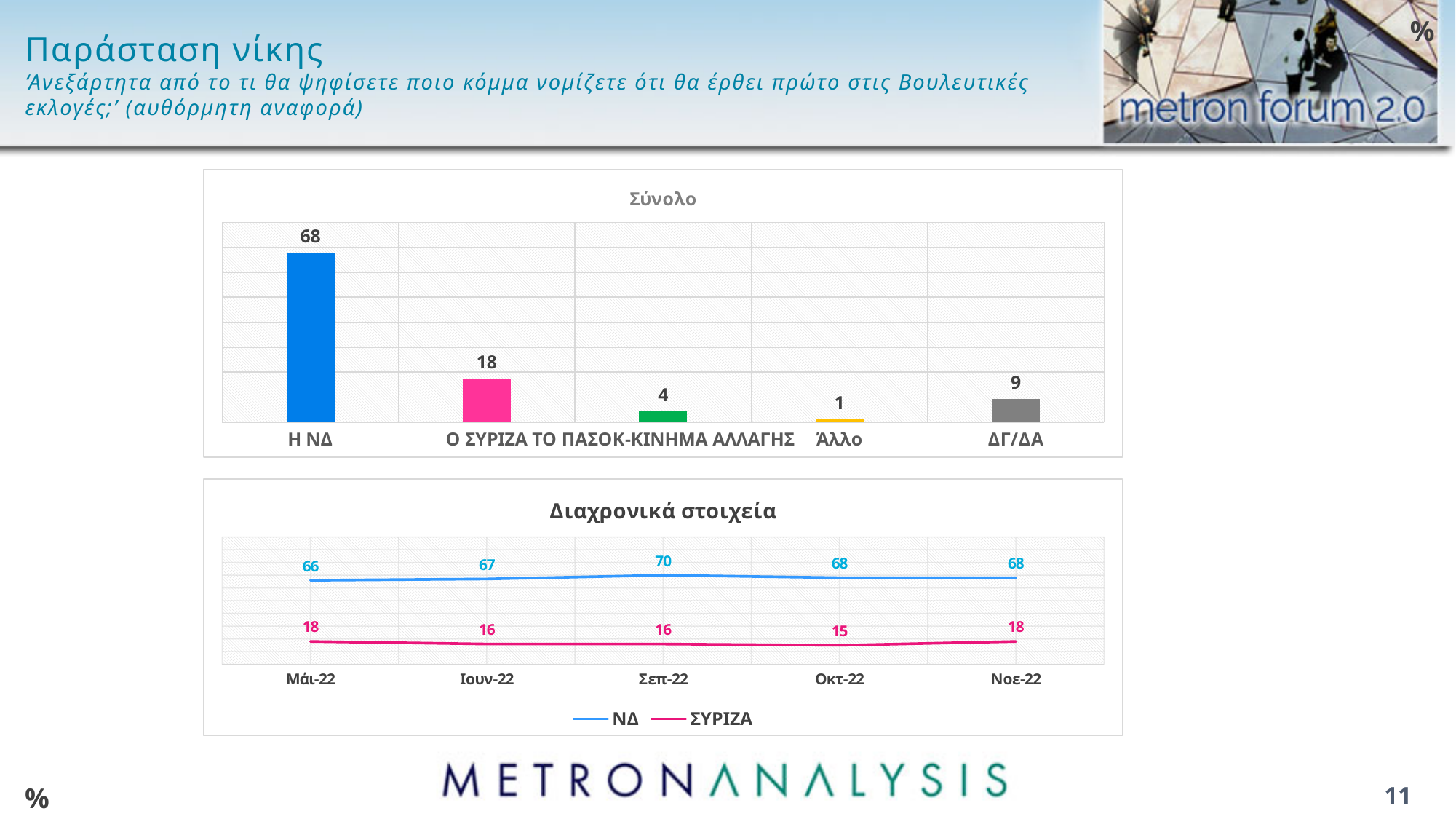
In the 'Σύνολο' chart, what is the value for ΔΓ/ΔΑ? 9 In the 'Σύνολο' chart, what is the difference between Η ΝΔ and Ο ΣΥΡΙΖΑ? 50 What kind of chart is the 'Σύνολο' chart? bar chart In the 'Διαχρονικά στοιχεία' chart, what is the difference between ΝΔ and ΣΥΡΙΖΑ in Νοε-22? 50 In the 'Διαχρονικά στοιχεία' chart, what is the value for ΝΔ in Σεπ-22? 70 In the 'Σύνολο' chart, which category has the lowest value? Άλλο In the 'Διαχρονικά στοιχεία' chart, in which month does ΝΔ reach its highest value? Σεπ-22 In the 'Σύνολο' chart, what is the value for Η ΝΔ? 68 In the 'Διαχρονικά στοιχεία' chart, what is the value for ΣΥΡΙΖΑ in Οκτ-22? 15 In the 'Σύνολο' chart, how many categories are shown? 5 In the 'Διαχρονικά στοιχεία' chart, how many series does the legend list? 2 What kind of chart is the 'Διαχρονικά στοιχεία' chart? line chart